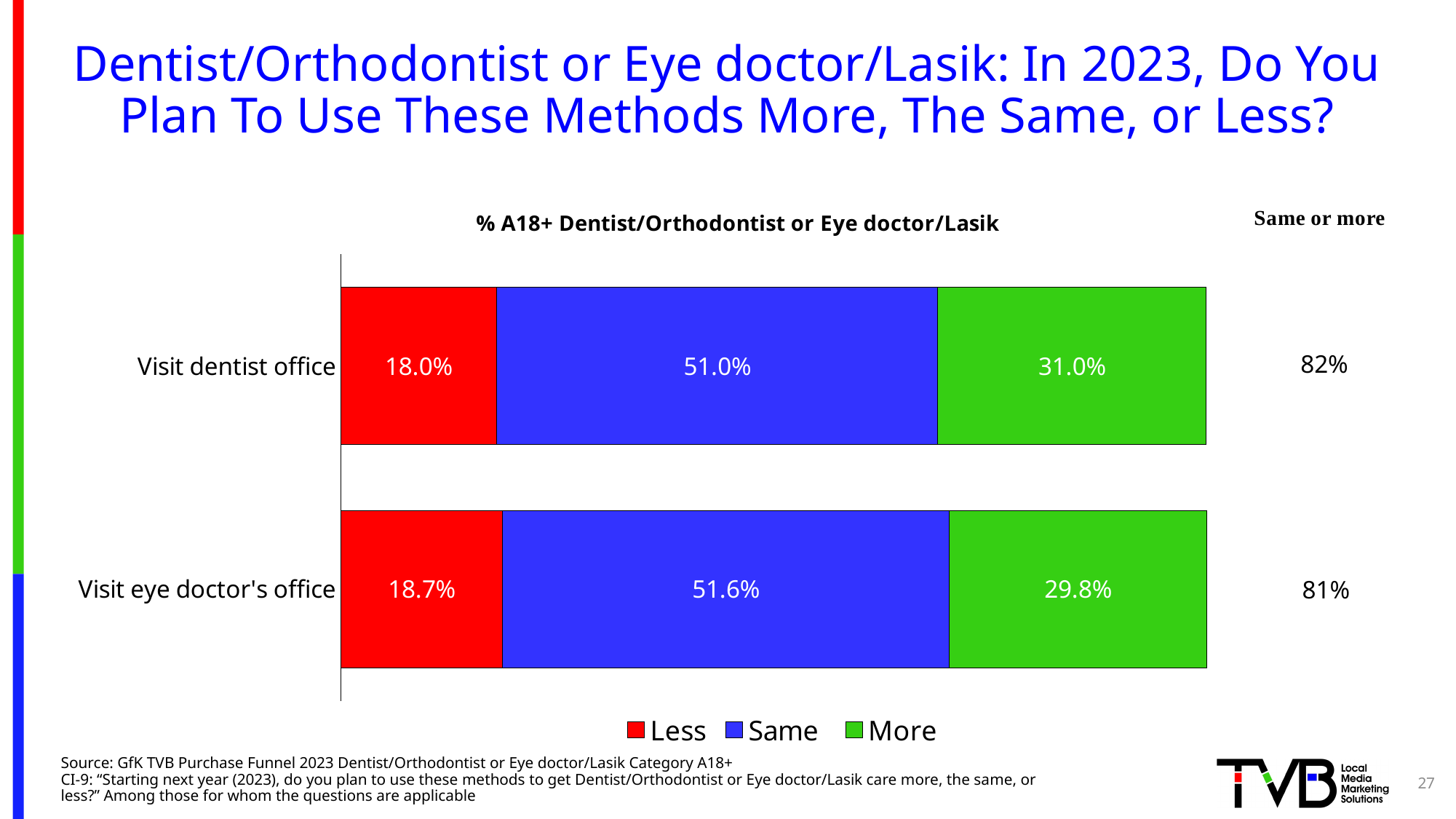
What kind of chart is shown on the slide? Stacked bar chart How many categories are shown on the chart? 2 What colour represents the 'More' series in the chart? Green Which series is the largest segment in both bars? Same What is the 'Same or more' figure shown for Visit dentist office? 82% What percentage of respondents plan to visit the eye doctor's office more in 2023? 29.8% Which category has the higher 'More' value, Visit dentist office or Visit eye doctor's office? Visit dentist office What is the difference between the 'Same' values for Visit eye doctor's office and Visit dentist office? 0.6% What is the difference between the 'More' values for Visit dentist office and Visit eye doctor's office? 1.2% What percentage of respondents plan to visit the dentist office the same amount in 2023? 51.0% How many series does the legend list? 3 What is the 'Less' value for Visit eye doctor's office? 18.7%